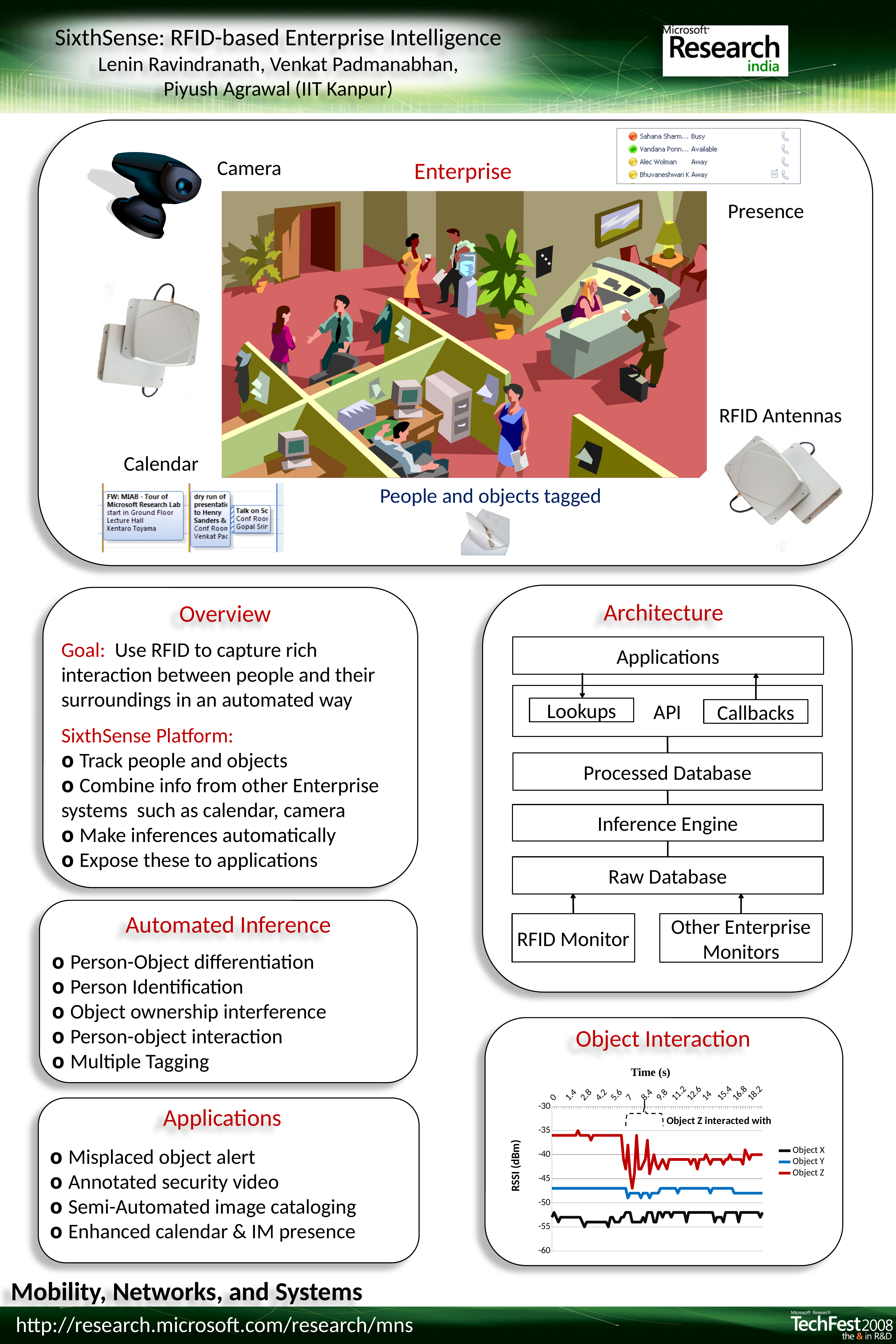
In the Object Interaction chart, does the RSSI of Object Z rise or fall between time 4.2 and time 9.8? fall How many series does the legend of the Object Interaction chart list? 3 What is the y-axis label of the Object Interaction chart? RSSI (dBm) In the Object Interaction chart, is the RSSI of Object Z at time 0 greater or less than -40? greater In the Object Interaction chart, which series has a higher RSSI at time 14: Object Y or Object X? Object Y In the Object Interaction chart, which series has the highest RSSI values throughout? Object Z In the Object Interaction chart, is the RSSI of Object Y at time 0 greater or less than -50? greater How many tick labels are shown on the Time (s) axis of the Object Interaction chart? 14 In the Object Interaction chart, which series has the lowest RSSI values throughout? Object X What kind of chart is shown in the Object Interaction panel? line chart In the Object Interaction chart, is the RSSI of Object X at time 0 greater or less than -50? less What are the series names in the legend of the Object Interaction chart? Object X, Object Y, Object Z